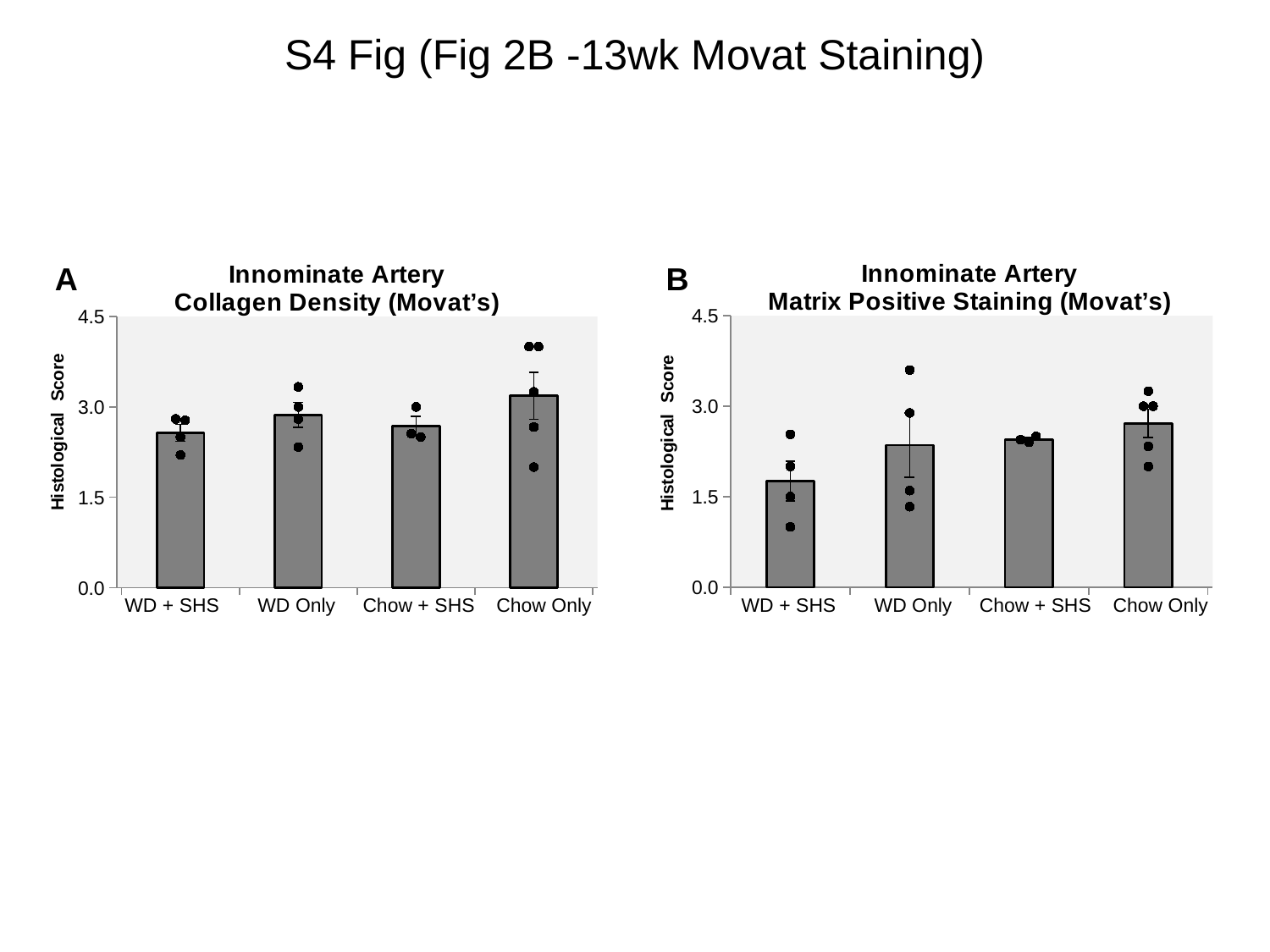
How many categories are shown on the x axis of chart A, Innominate Artery Collagen Density (Movat's)? 4 In chart B, Innominate Artery Matrix Positive Staining (Movat's), is the bar for Chow Only greater or less than 3.0? less What kind of chart is chart A, Innominate Artery Collagen Density (Movat's)? bar chart In chart A, Innominate Artery Collagen Density (Movat's), which category has the highest bar? Chow Only In chart B, Innominate Artery Matrix Positive Staining (Movat's), which category has the lowest bar? WD + SHS In chart B, Innominate Artery Matrix Positive Staining (Movat's), is the bar for WD + SHS greater or less than 1.5? greater What is the y-axis title of chart B, Innominate Artery Matrix Positive Staining (Movat's)? Histological Score In chart A, Innominate Artery Collagen Density (Movat's), is the bar for Chow Only greater or less than 3.0? greater In chart A, Innominate Artery Collagen Density (Movat's), which bar is taller, Chow Only or WD + SHS? Chow Only In chart B, Innominate Artery Matrix Positive Staining (Movat's), which category has the highest bar? Chow Only In chart B, Innominate Artery Matrix Positive Staining (Movat's), which bar is taller, Chow + SHS or WD + SHS? Chow + SHS